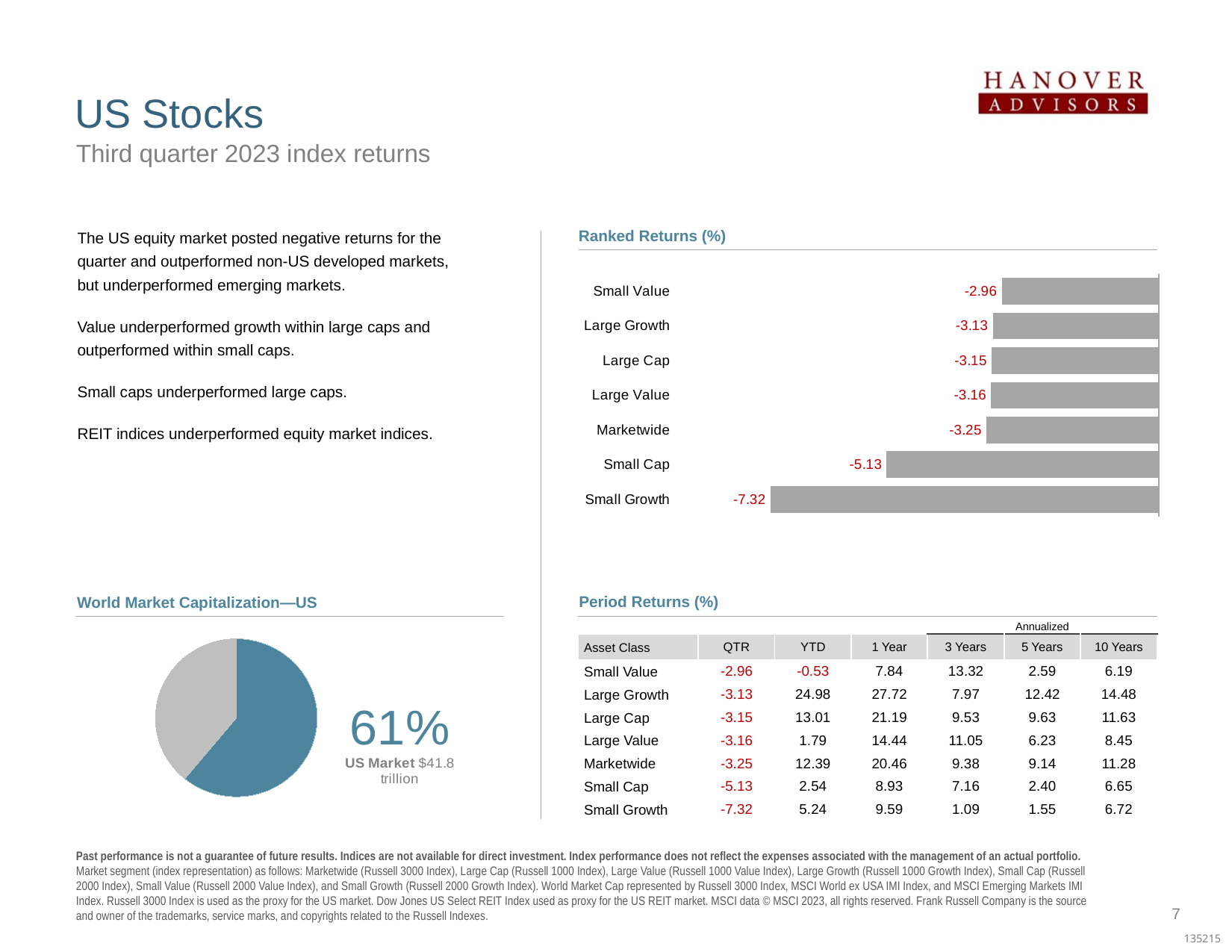
In the World Market Capitalization—US chart, what is the size of the US market? $41.8 trillion In the Ranked Returns (%) chart, what is the difference between the values for Small Cap and Small Growth? 2.19 What kind of chart is the Ranked Returns (%) chart? Bar chart In the Ranked Returns (%) chart, which is larger, the value for Marketwide or the value for Small Cap? Marketwide In the Ranked Returns (%) chart, what is the value for Small Cap? -5.13 In the Ranked Returns (%) chart, what is the value for Small Value? -2.96 In the World Market Capitalization—US chart, what share of world market capitalization does the US market represent? 61% What kind of chart is the World Market Capitalization—US chart? Pie chart In the Ranked Returns (%) chart, which category has the lowest value? Small Growth In the Ranked Returns (%) chart, what is the value for Marketwide? -3.25 How many categories are shown in the Ranked Returns (%) chart? 7 In the Ranked Returns (%) chart, which category has the highest value? Small Value